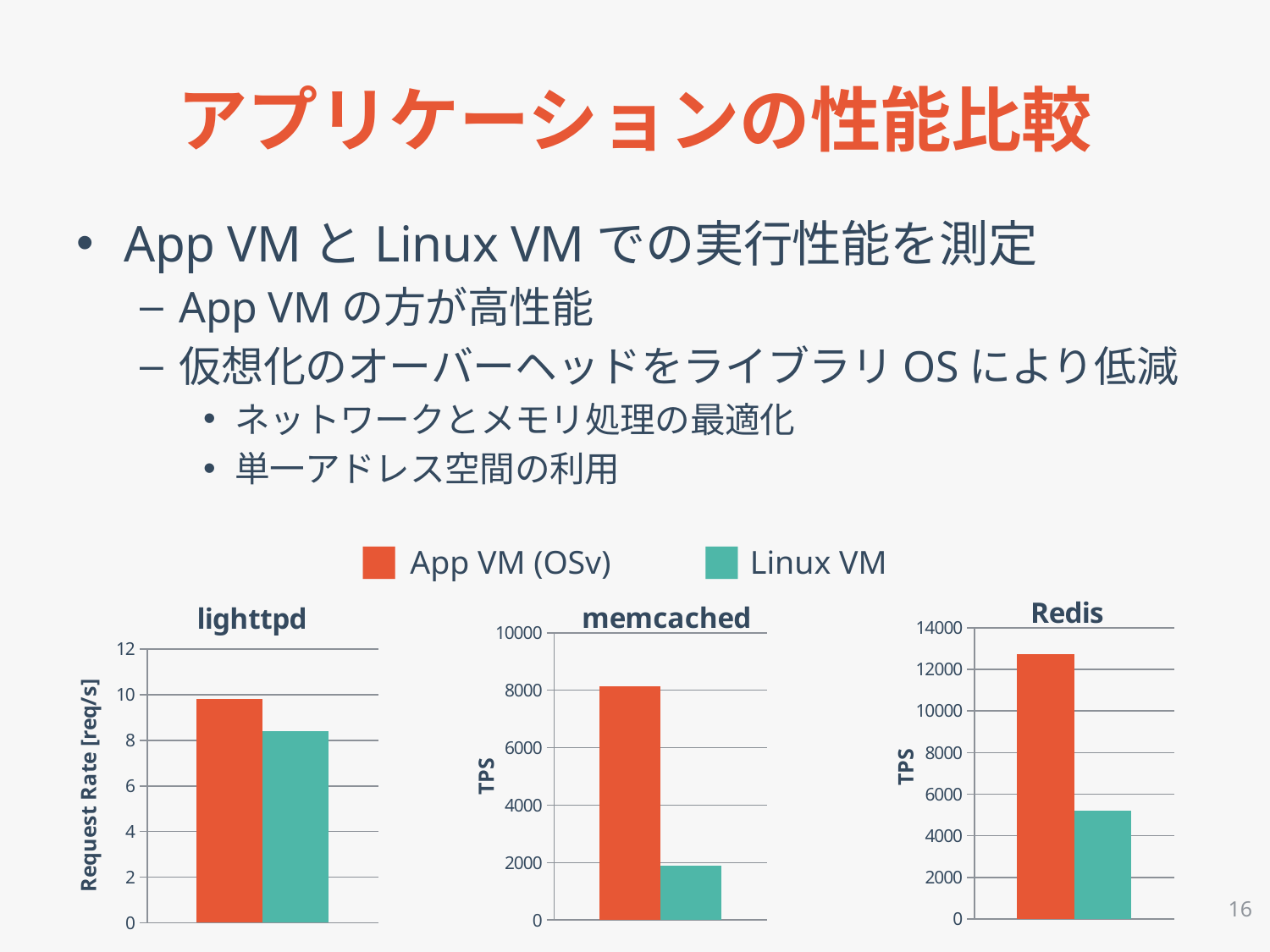
How many series does the shared legend list? 2 In the lighttpd chart, which series has the higher bar, App VM (OSv) or Linux VM? App VM (OSv) In the memcached chart, which series has the lower bar? Linux VM In the Redis chart, is the value for Linux VM greater or less than 6000? less In the Redis chart, is the value for App VM (OSv) greater or less than 12000? greater In the lighttpd chart, is the value for App VM (OSv) greater or less than 8? greater What kind of chart is the memcached chart? bar chart In the Redis chart, which series has the higher bar? App VM (OSv) What is the y-axis label of the lighttpd chart? Request Rate [req/s]